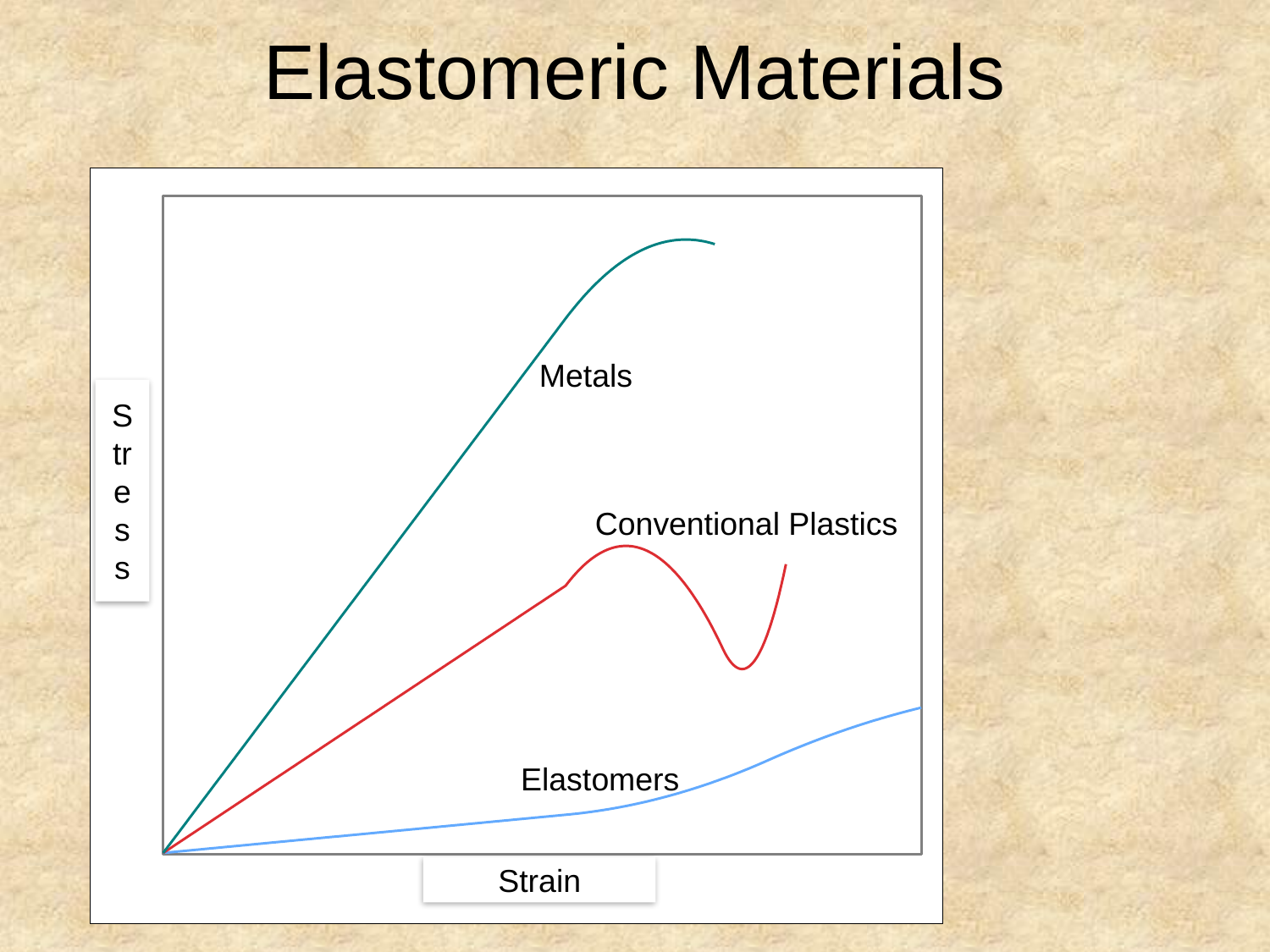
Which curve reaches a higher stress, Metals or Conventional Plastics? Metals Which material curve reaches the highest stress on the chart? Metals Which material curve stays at the lowest stress on the chart? Elastomers Which curve reaches a higher stress, Conventional Plastics or Elastomers? Conventional Plastics What is the label on the horizontal axis of the chart? Strain Which material curve shows a dip (a drop followed by a rise) in stress as strain increases? Conventional Plastics Which curve extends furthest along the strain axis? Elastomers How many material curves are plotted on the chart? 3 What is the title of the slide containing the chart? Elastomeric Materials What kind of chart is shown on the slide? line chart What is the label on the vertical axis of the chart? Stress Does the Elastomers curve rise or fall as strain increases? rise